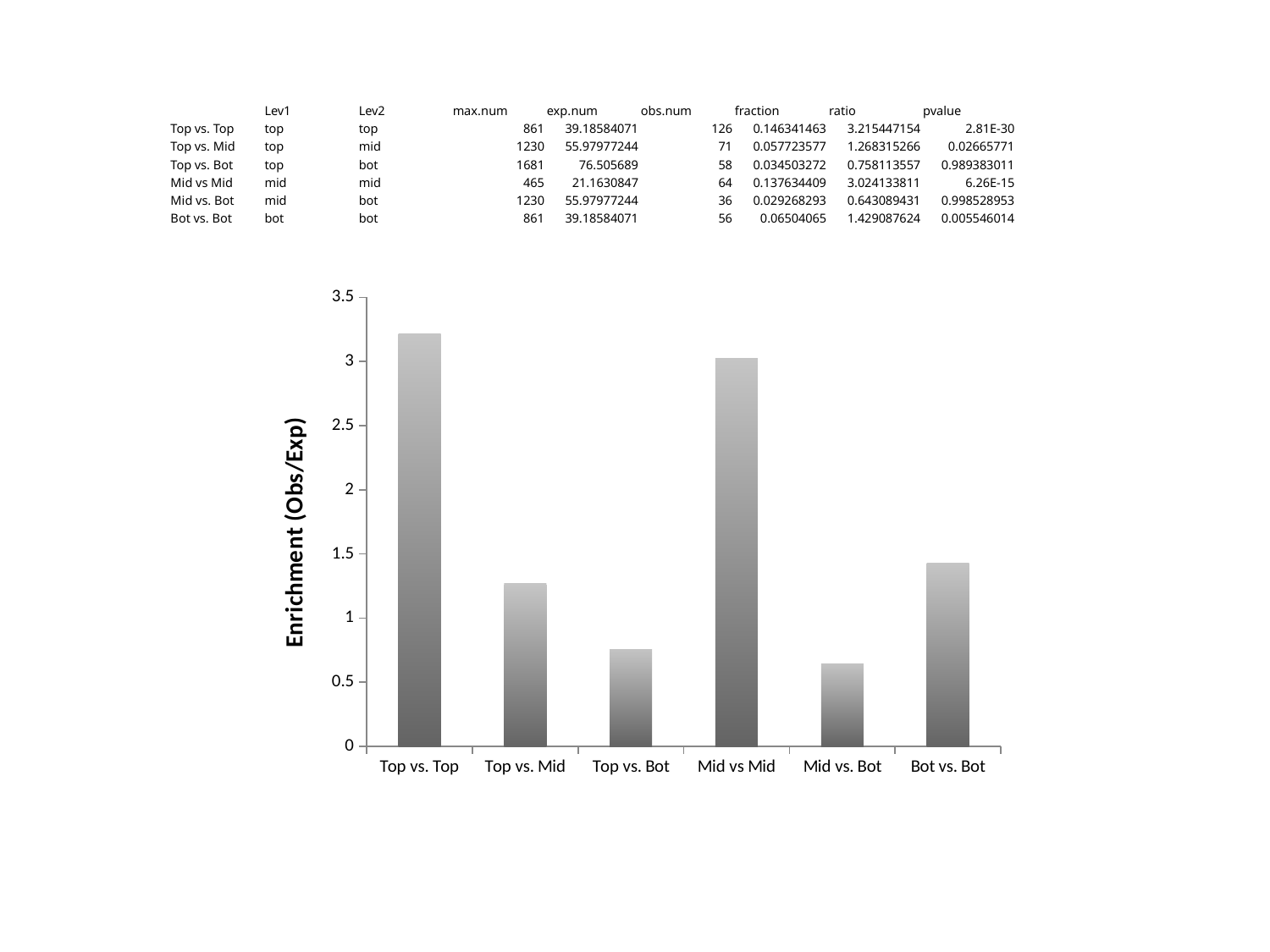
Is the value for Mid vs. Bot greater or less than 1? less Which category has the highest bar in the chart? Top vs. Top What kind of chart is shown on the slide? bar chart Which category has the lowest bar in the chart? Mid vs. Bot Is the value for Top vs. Top greater or less than 3? greater Is the value for Bot vs. Bot greater or less than 1? greater What is the title of the y axis of the bar chart? Enrichment (Obs/Exp) Do the values rise or fall across the first three categories, from Top vs. Top to Top vs. Bot? fall Which is larger, the value for Top vs. Mid or the value for Bot vs. Bot? Bot vs. Bot How many categories are plotted on the x axis of the bar chart? 6